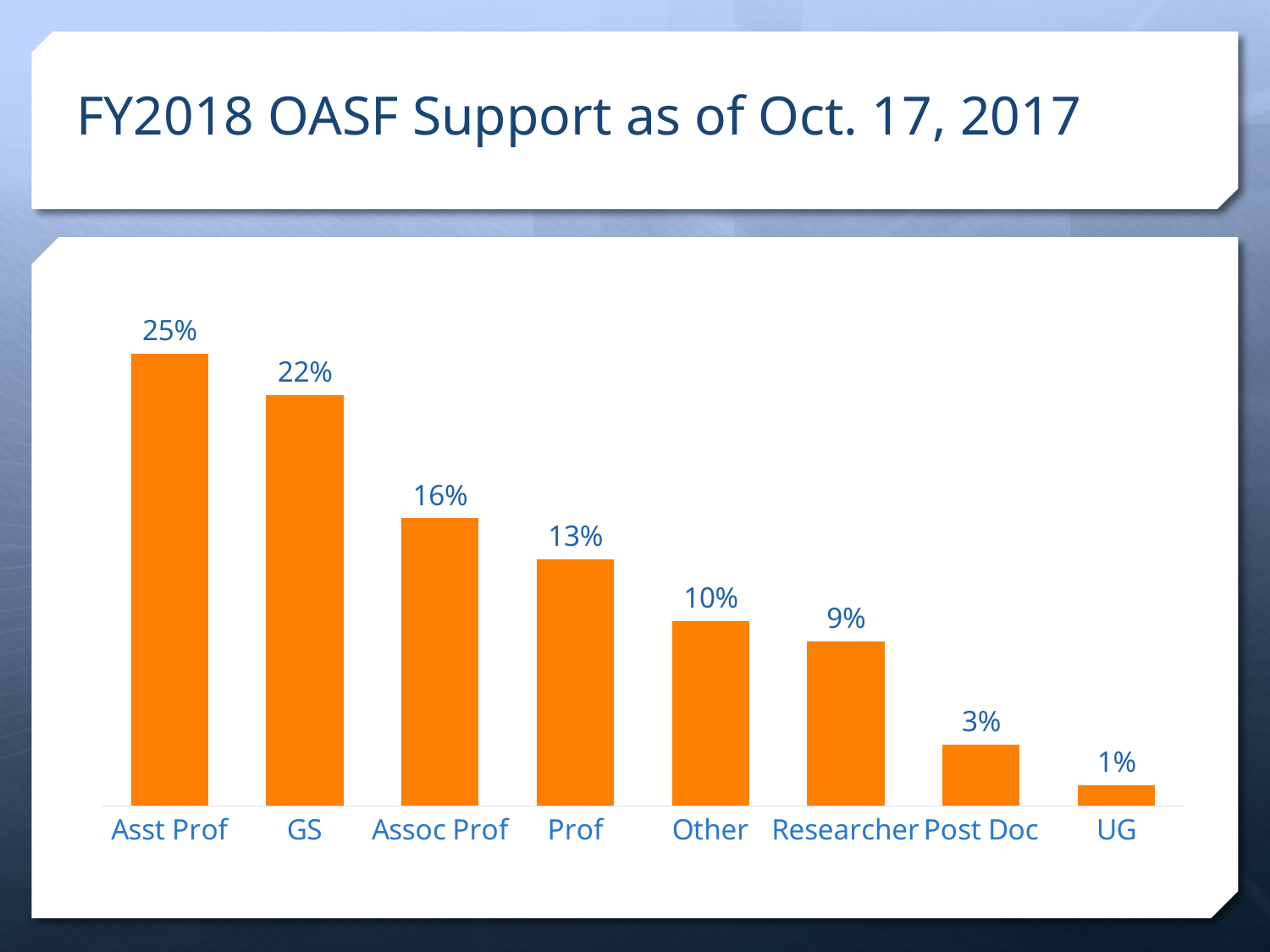
What is the value for Post Doc? 3% How many categories are shown on the x axis? 8 What is the difference between the values for Asst Prof and GS? 3% What is the value for Asst Prof? 25% Which category has the highest value? Asst Prof What is the value for Researcher? 9% What is the difference between the values for Assoc Prof and Prof? 3% Which is larger, the value for Other or the value for Researcher? Other Do the values rise or fall from left to right along the x axis? Fall Which category has the lowest value? UG What kind of chart is shown on the slide? Bar chart What is the title of the slide? FY2018 OASF Support as of Oct. 17, 2017